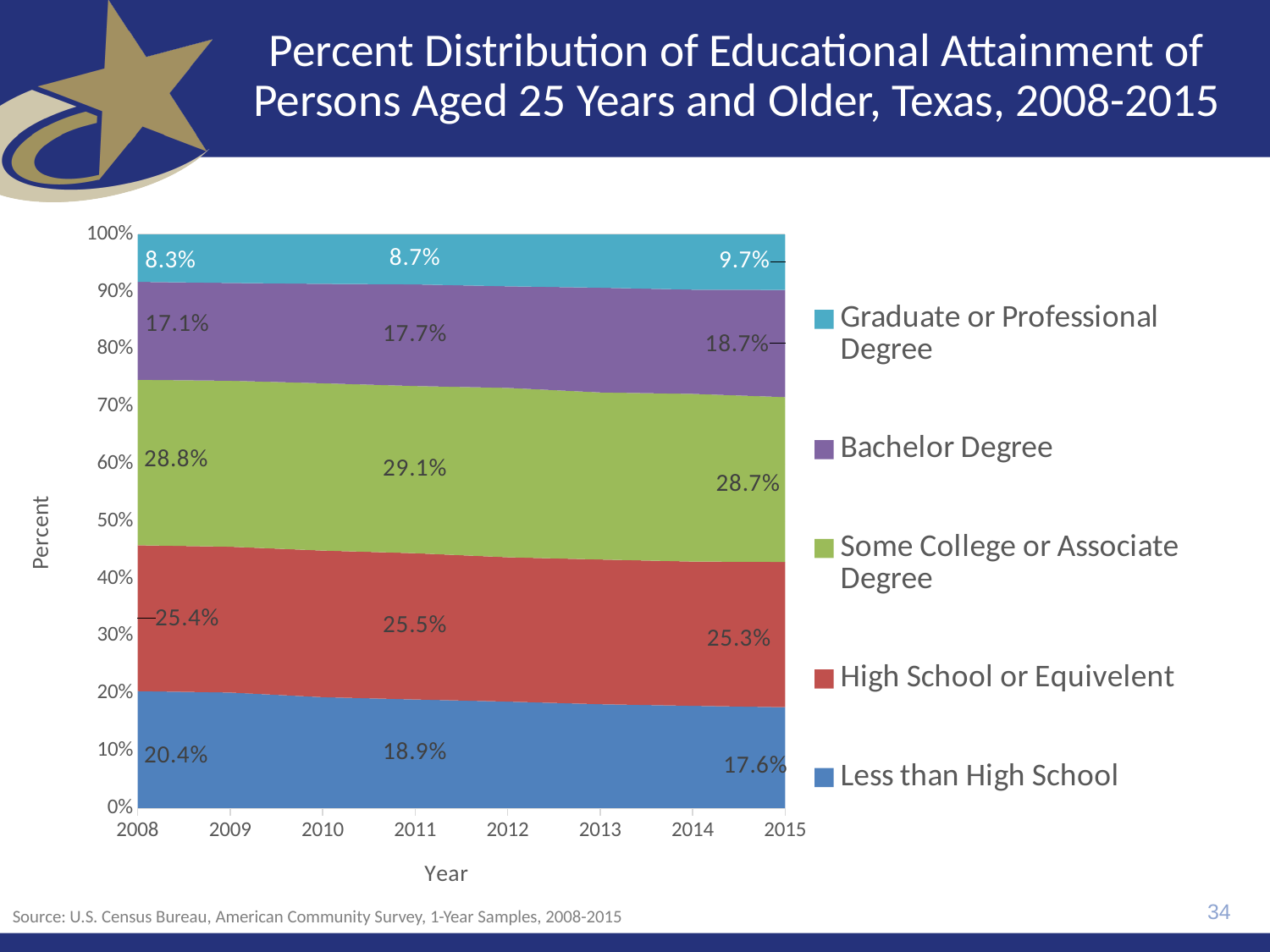
What was the share with a Graduate or Professional Degree in 2015? 9.7% Which was larger in 2015: the share with a Bachelor Degree or the share with Less than High School? Bachelor Degree By how many percentage points did the Less than High School share change from 2008 to 2015? 2.8 percentage points lower How many educational attainment categories does the legend list? 5 Which educational attainment category had the smallest share in 2015? Graduate or Professional Degree What kind of chart is shown on the slide? Stacked area chart What percentage of persons aged 25 and older had less than a high school education in Texas in 2008? 20.4% What was the share with Some College or Associate Degree in 2015? 28.7% Did the share with a Graduate or Professional Degree rise or fall from 2008 to 2015? Rise Which educational attainment category had the largest share in 2008? Some College or Associate Degree How many years are shown on the x axis? 8 What was the share with a Bachelor Degree in 2011? 17.7%